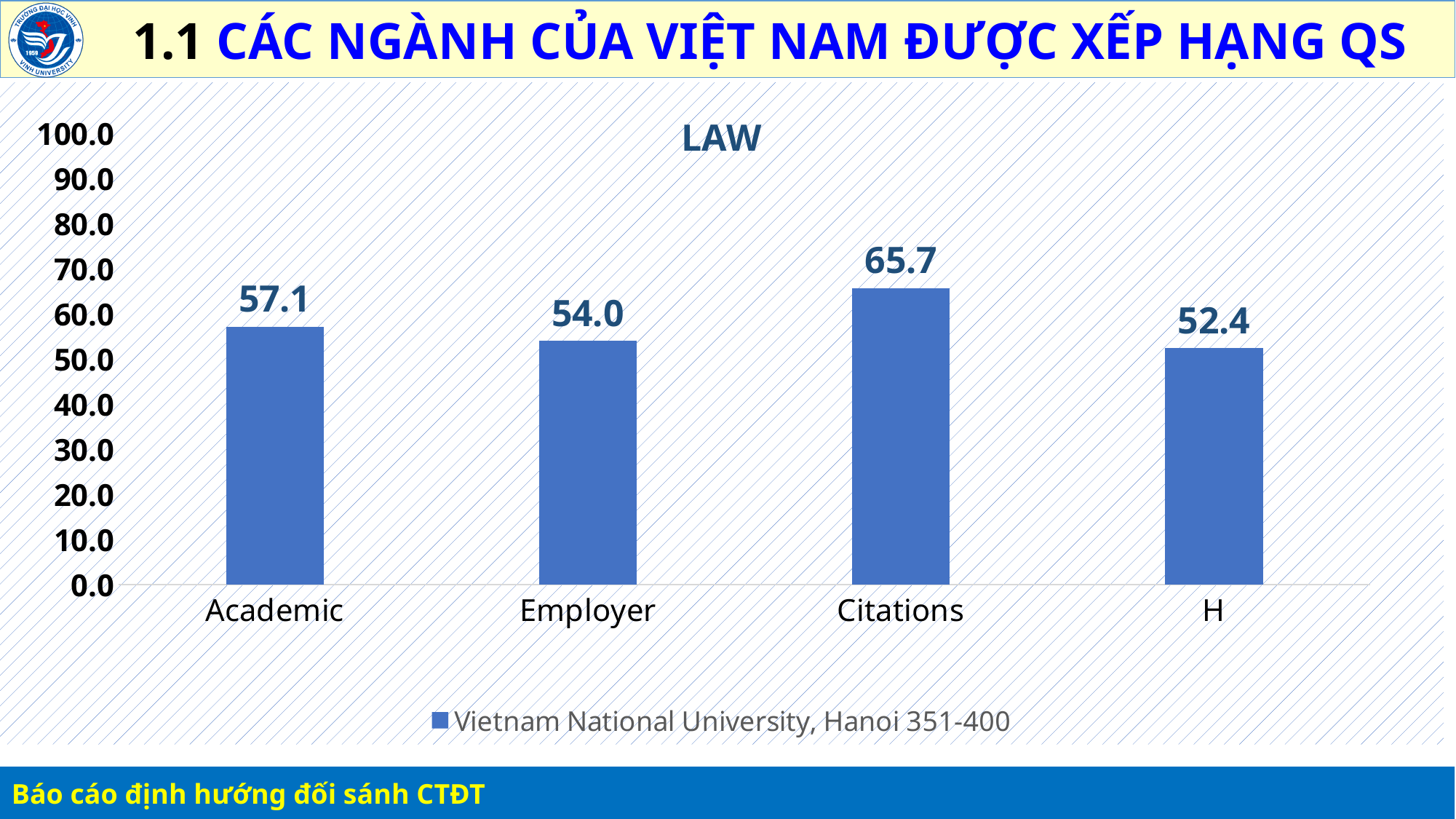
What is the value for H? 52.4 Which category has the lowest value? H What is the difference between the values for Citations and Academic? 8.6 How many categories are shown on the x axis? 4 What is the value for Employer? 54.0 What is the title of the chart? LAW Is the value for Citations greater or less than 60.0? greater Which category has the highest value? Citations Which is larger, the value for Academic or the value for Employer? Academic What is the value for Citations? 65.7 What is the value for Academic? 57.1 What kind of chart is shown? bar chart